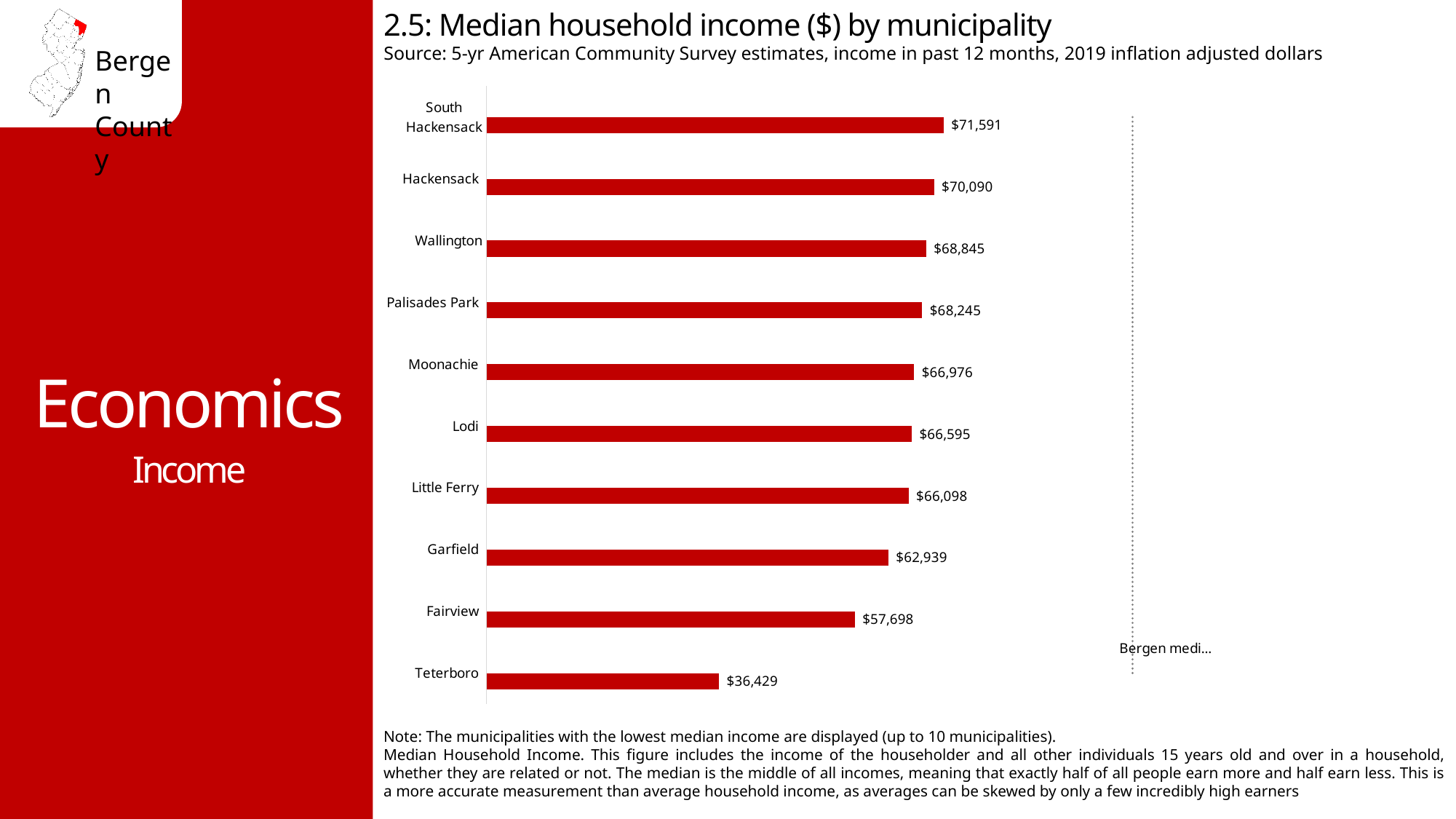
Which municipality has the lowest median household income shown on the chart? Teterboro What is the median household income for Hackensack? $70,090 What is the title of the chart? 2.5: Median household income ($) by municipality What is the difference in median household income between South Hackensack and Teterboro? $35,162 Which has a higher median household income, Wallington or Palisades Park? Wallington Which municipality has the highest median household income shown on the chart? South Hackensack What is the median household income for Lodi? $66,595 What is the median household income for Teterboro? $36,429 What is the median household income for Fairview? $57,698 What is the difference in median household income between Garfield and Fairview? $5,241 How many municipalities are shown on the chart? 10 What kind of chart is shown on the slide? Bar chart